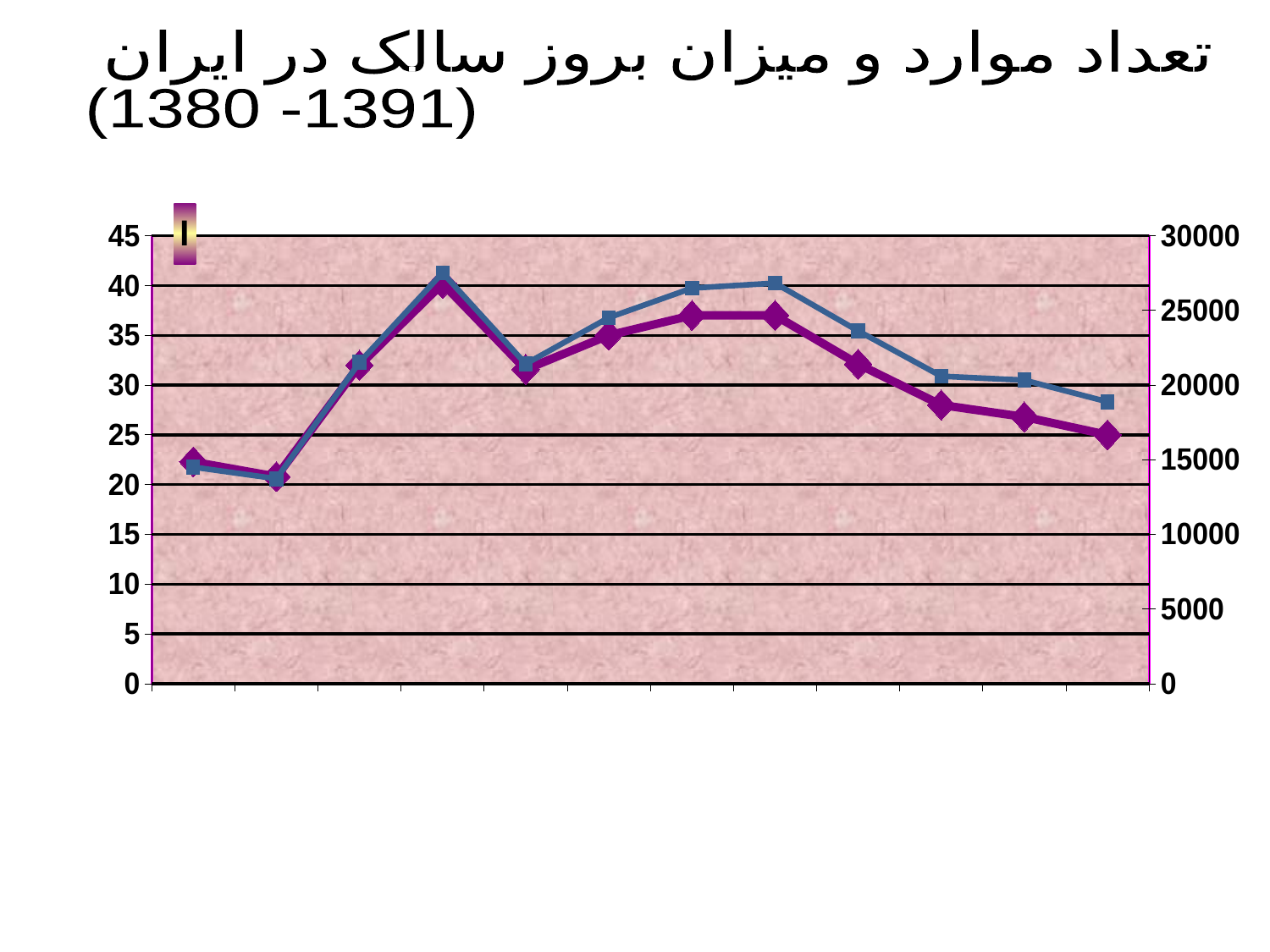
What kind of chart is shown on the slide? line chart How many lines are plotted on the chart? 2 Which point of the purple diamond line is the highest: the fourth from the left or the last on the right? the fourth from the left Do the values of the purple diamond line rise or fall over the last five points on the right side of the chart? fall Is the value of the purple diamond line at its second point from the left greater or less than 25 on the left axis? less What is the highest tick value shown on the left vertical axis? 45 Is the value of the blue square line at its fourth point from the left greater or less than 25000 on the right axis? greater Is the value of the blue square line at its last point on the right greater or less than 20000 on the right axis? less How many data points does each line on the chart have? 12 What is the highest tick value shown on the right vertical axis? 30000